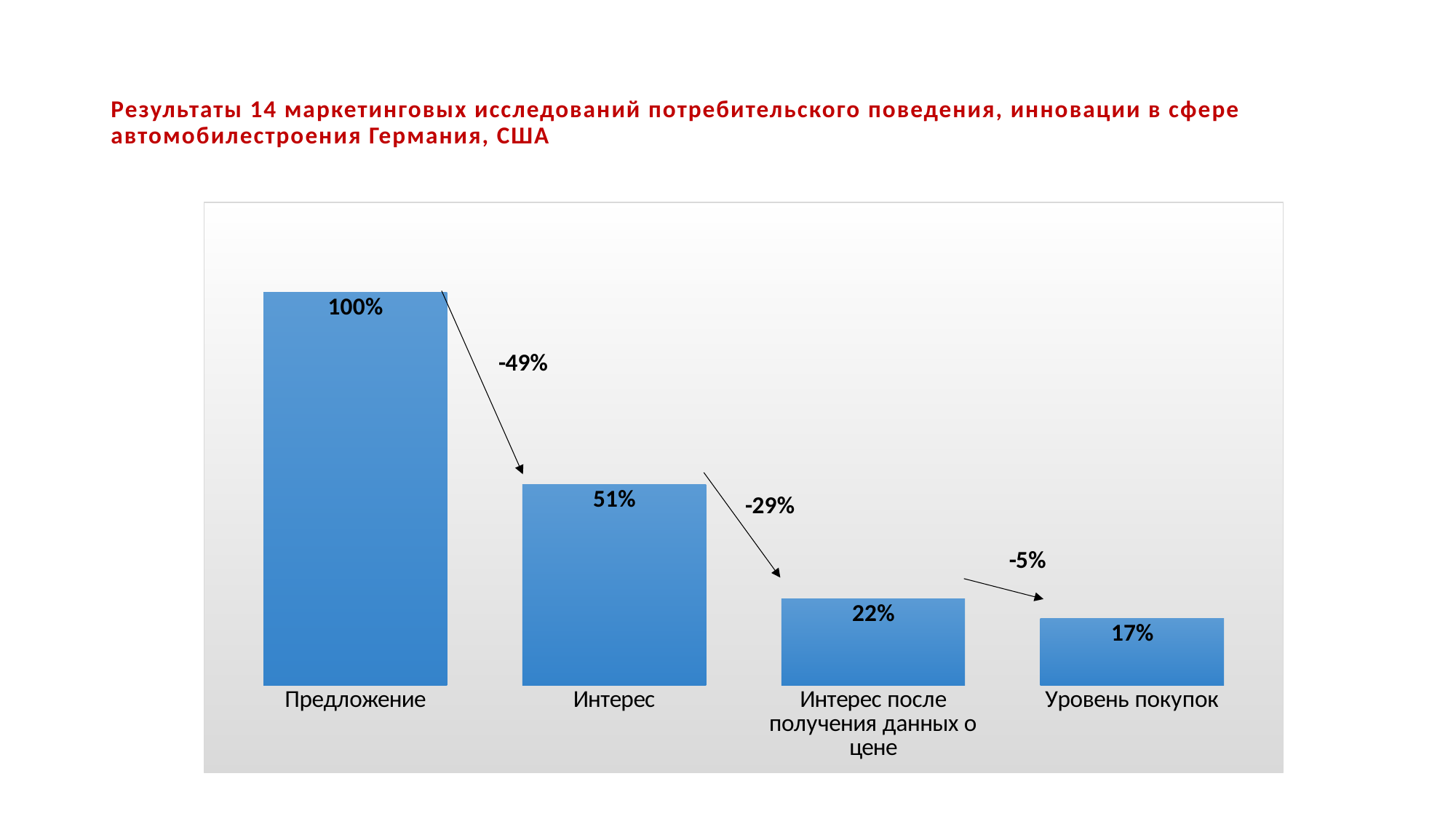
Do the values rise or fall from left to right along the x axis? Fall Which is larger, the value for Интерес or the value for Уровень покупок? Интерес What kind of chart is shown on the slide? Bar chart What is the value for Интерес после получения данных о цене? 22% Which category has the lowest value? Уровень покупок How many categories are shown in the chart? 4 What is the difference between the values for Предложение and Интерес? 49% What is the value for Уровень покупок? 17% What is the value for Предложение? 100% What is the value for Интерес? 51% Which category has the highest value? Предложение What is the difference between the values for Интерес после получения данных о цене and Уровень покупок? 5%